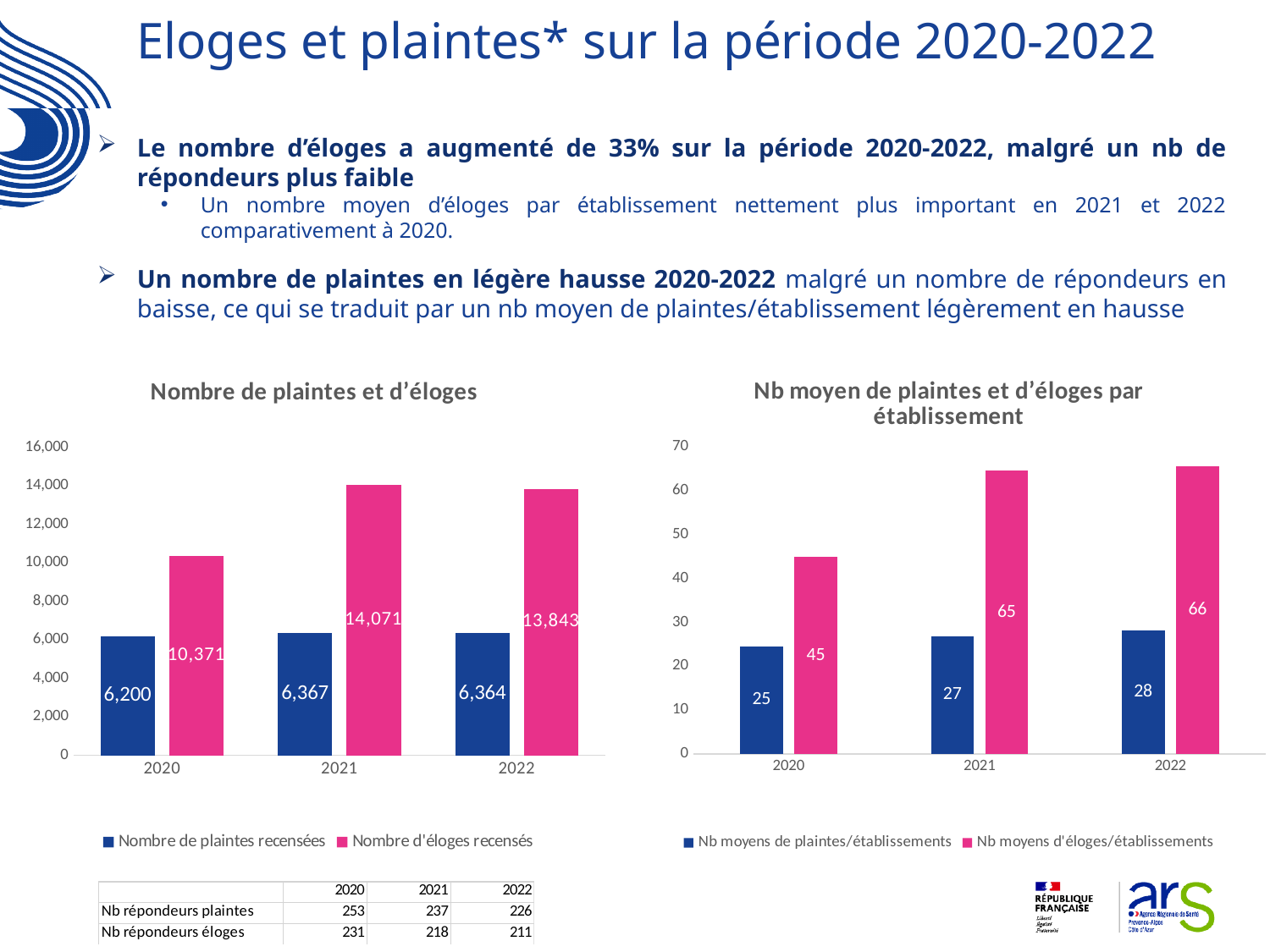
In the chart 'Nombre de plaintes et d'éloges', what is the value of 'Nombre d'éloges recensés' for 2021? 14,071 In the chart 'Nb moyen de plaintes et d'éloges par établissement', which year has the lowest value for 'Nb moyens de plaintes/établissements'? 2020 In the chart 'Nombre de plaintes et d'éloges', what is the value of 'Nombre de plaintes recensées' for 2020? 6,200 In the chart 'Nombre de plaintes et d'éloges', which year has the highest value for 'Nombre d'éloges recensés'? 2021 In the chart 'Nb moyen de plaintes et d'éloges par établissement', what is the value of 'Nb moyens d'éloges/établissements' for 2022? 66 In the chart 'Nombre de plaintes et d'éloges', what is the difference between 'Nombre d'éloges recensés' in 2021 and in 2020? 3,700 In the chart 'Nombre de plaintes et d'éloges', is the value for 'Nombre d'éloges recensés' in 2020 greater or less than 10,000? greater In the chart 'Nb moyen de plaintes et d'éloges par établissement', does 'Nb moyens de plaintes/établissements' rise or fall from 2020 to 2022? rise In the chart 'Nb moyen de plaintes et d'éloges par établissement', what is the difference between 'Nb moyens d'éloges/établissements' and 'Nb moyens de plaintes/établissements' in 2021? 38 In the chart 'Nombre de plaintes et d'éloges', how many series does the legend list? 2 What kind of chart is 'Nb moyen de plaintes et d'éloges par établissement'? bar chart In the chart 'Nb moyen de plaintes et d'éloges par établissement', how many years are shown on the x axis? 3